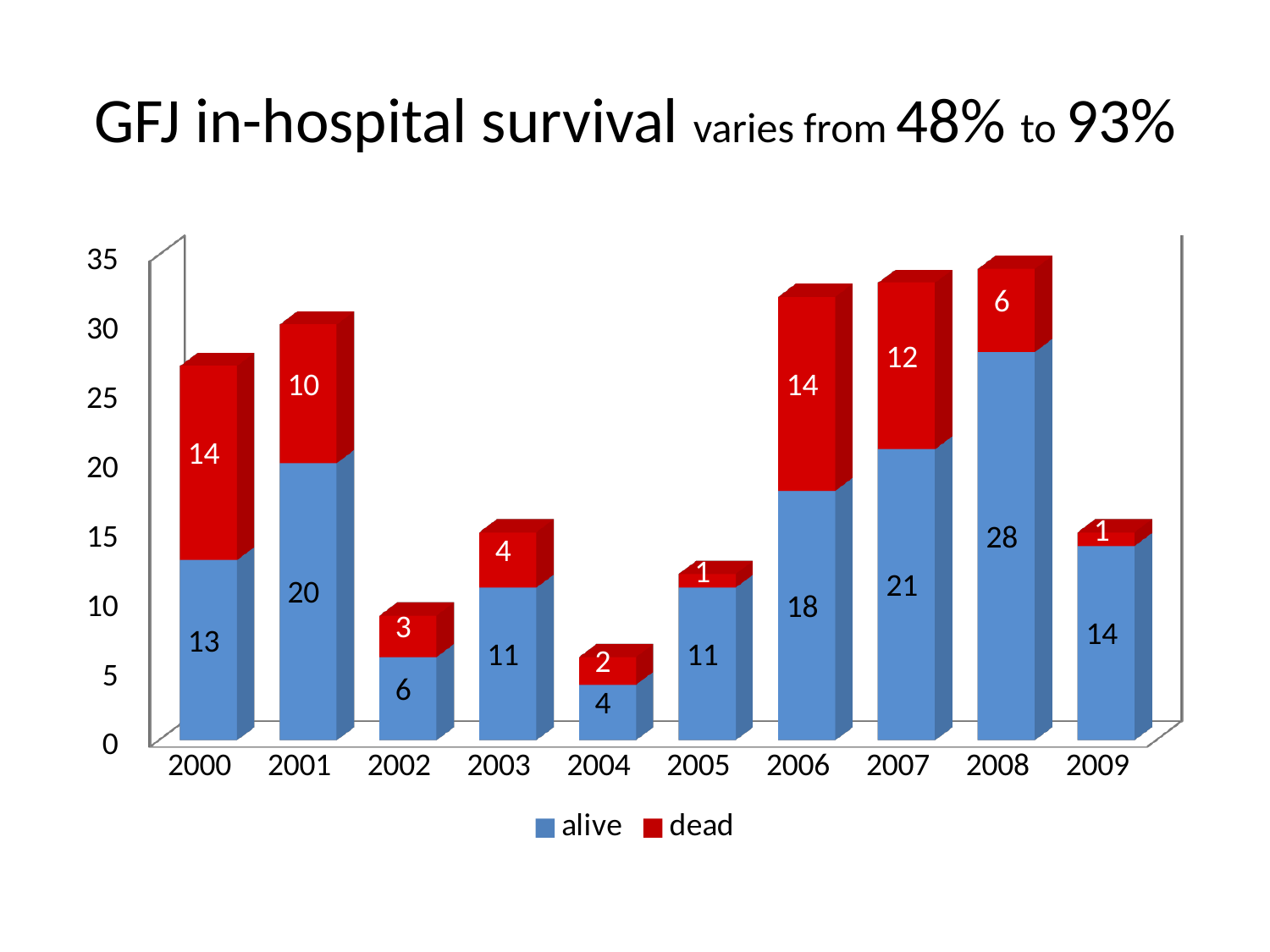
What is the difference between the alive values for 2001 and 2002? 14 What is the value for alive in 2008? 28 How many years are shown on the x axis? 10 What is the value for alive in 2004? 4 What kind of chart is shown on the slide? stacked bar chart What is the total of the stacked bar for 2006? 32 How many series does the legend list? 2 Which year has the highest alive value? 2008 What is the total of the stacked bar for 2009? 15 Which year has the lowest alive value? 2004 What is the value for dead in 2006? 14 Which is larger, the dead value for 2000 or the dead value for 2007? 2000